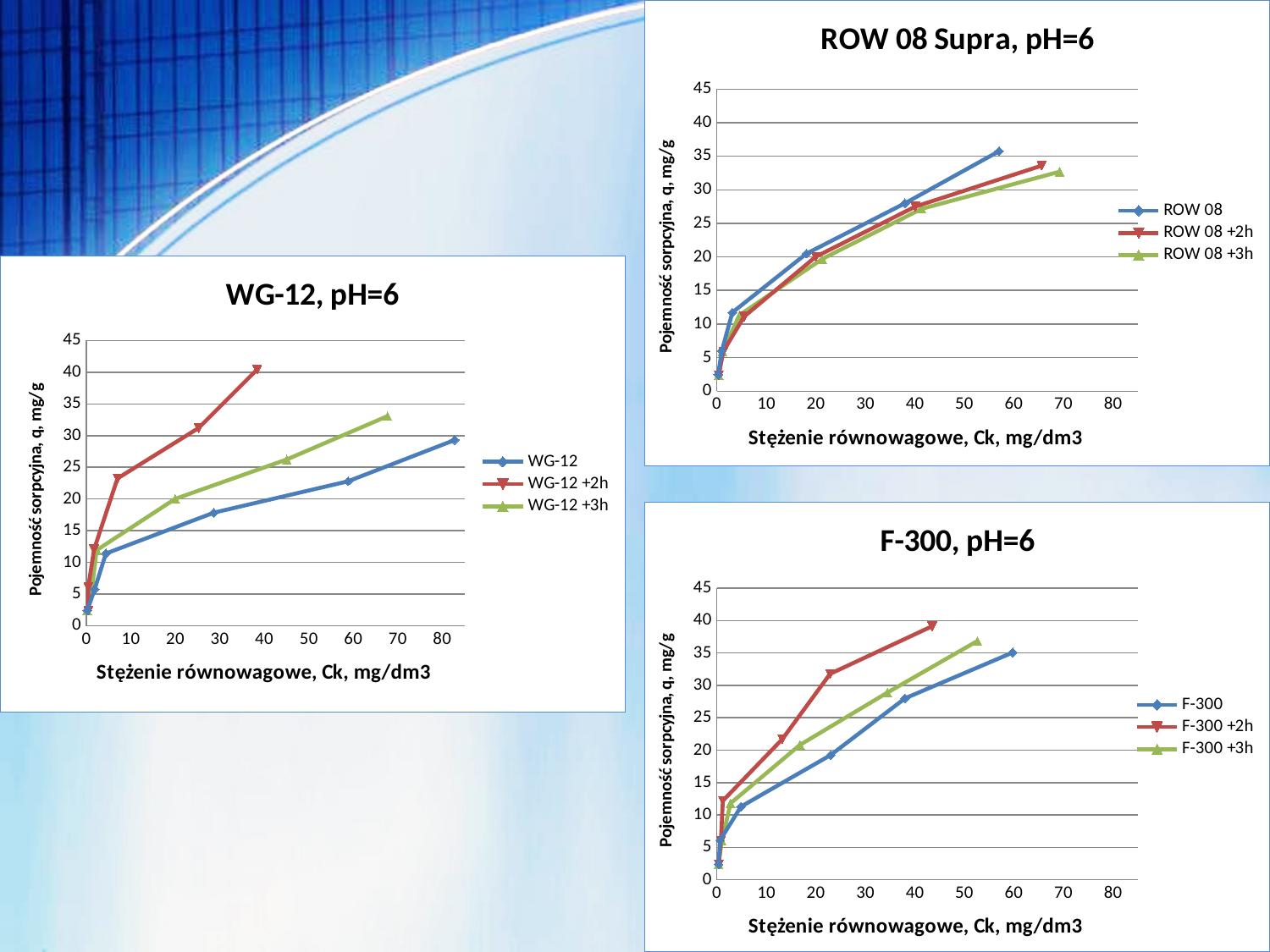
How many charts are shown on the slide? 3 In the "WG-12, pH=6" chart, which series reaches a higher maximum value: WG-12 or WG-12 +2h? WG-12 +2h What is the x-axis label of the "ROW 08 Supra, pH=6" chart? Stężenie równowagowe, Ck, mg/dm3 In the "ROW 08 Supra, pH=6" chart, does the ROW 08 +3h series rise or fall along the x axis? rise How many series does the legend of the "ROW 08 Supra, pH=6" chart list? 3 What is the y-axis label of the "F-300, pH=6" chart? Pojemność sorpcyjna, q, mg/g What kind of chart is the "WG-12, pH=6" chart? line chart In the "F-300, pH=6" chart, is the highest value of the F-300 +2h series greater or less than 35? greater In the "WG-12, pH=6" chart, does the WG-12 series rise or fall as the x-axis value increases? rise How many series does the legend of the "WG-12, pH=6" chart list? 3 In the "ROW 08 Supra, pH=6" chart, is the highest value of the ROW 08 series greater or less than 30? greater In the "WG-12, pH=6" chart, is the highest value of the WG-12 +2h series greater or less than 35? greater